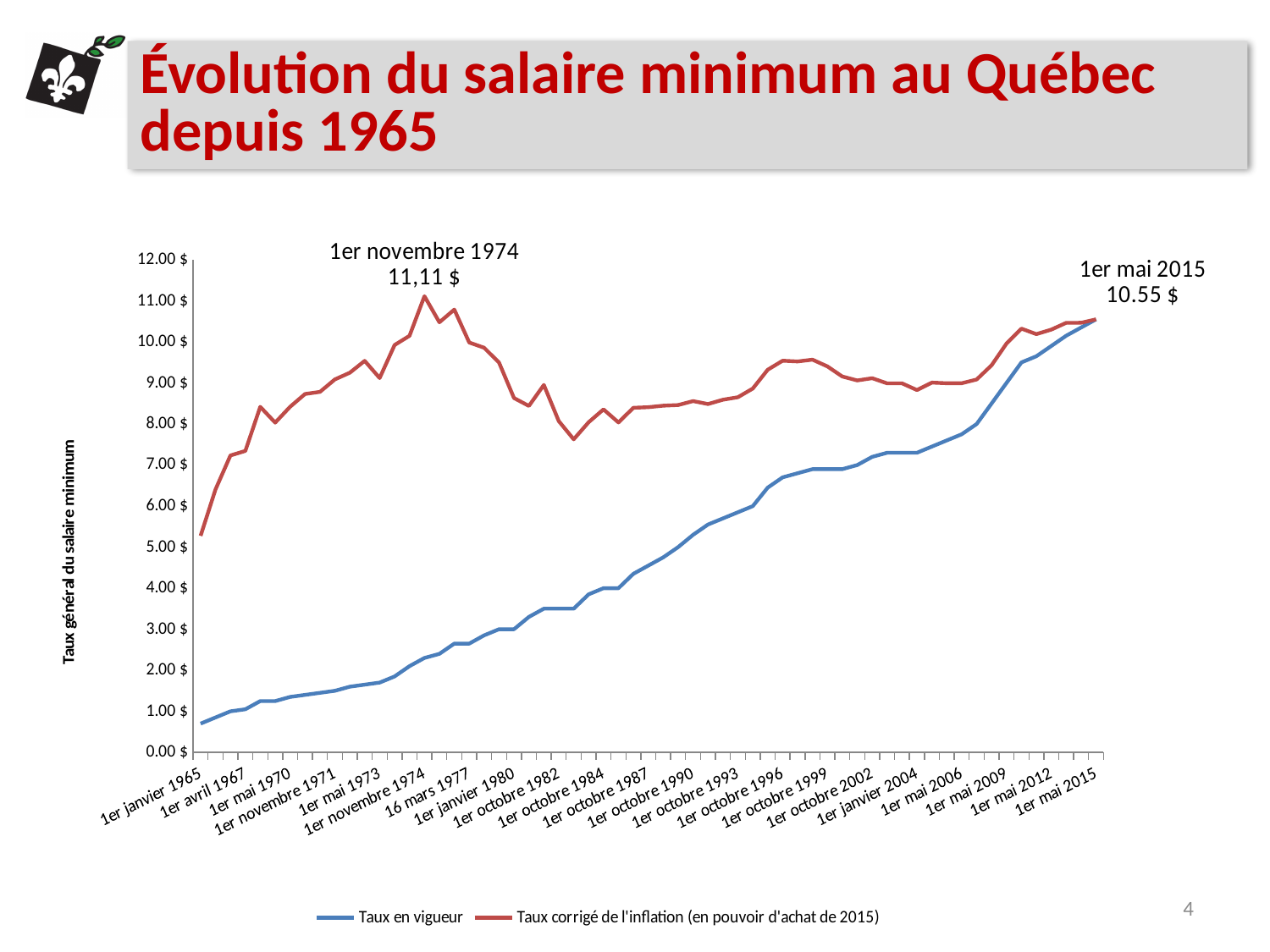
What are the two series named in the legend? Taux en vigueur; Taux corrigé de l'inflation (en pouvoir d'achat de 2015) What kind of chart is shown on the slide? line chart Is the Taux en vigueur value at 1er janvier 1965 greater or less than 1.00 $? less Is the Taux corrigé de l'inflation value at 1er janvier 1965 greater or less than 5.00 $? greater What value is annotated for 1er mai 2015? 10.55 $ At which date does the Taux corrigé de l'inflation series reach its highest value? 1er novembre 1974 Is the Taux en vigueur value at 1er octobre 1996 greater or less than 6.00 $? greater What is the title of the vertical axis? Taux général du salaire minimum How many series does the legend list? 2 At 1er octobre 1982, which series has the higher value, Taux en vigueur or Taux corrigé de l'inflation? Taux corrigé de l'inflation Does the Taux en vigueur series generally rise or fall from 1965 to 2015? rise What value is annotated for 1er novembre 1974? 11,11 $